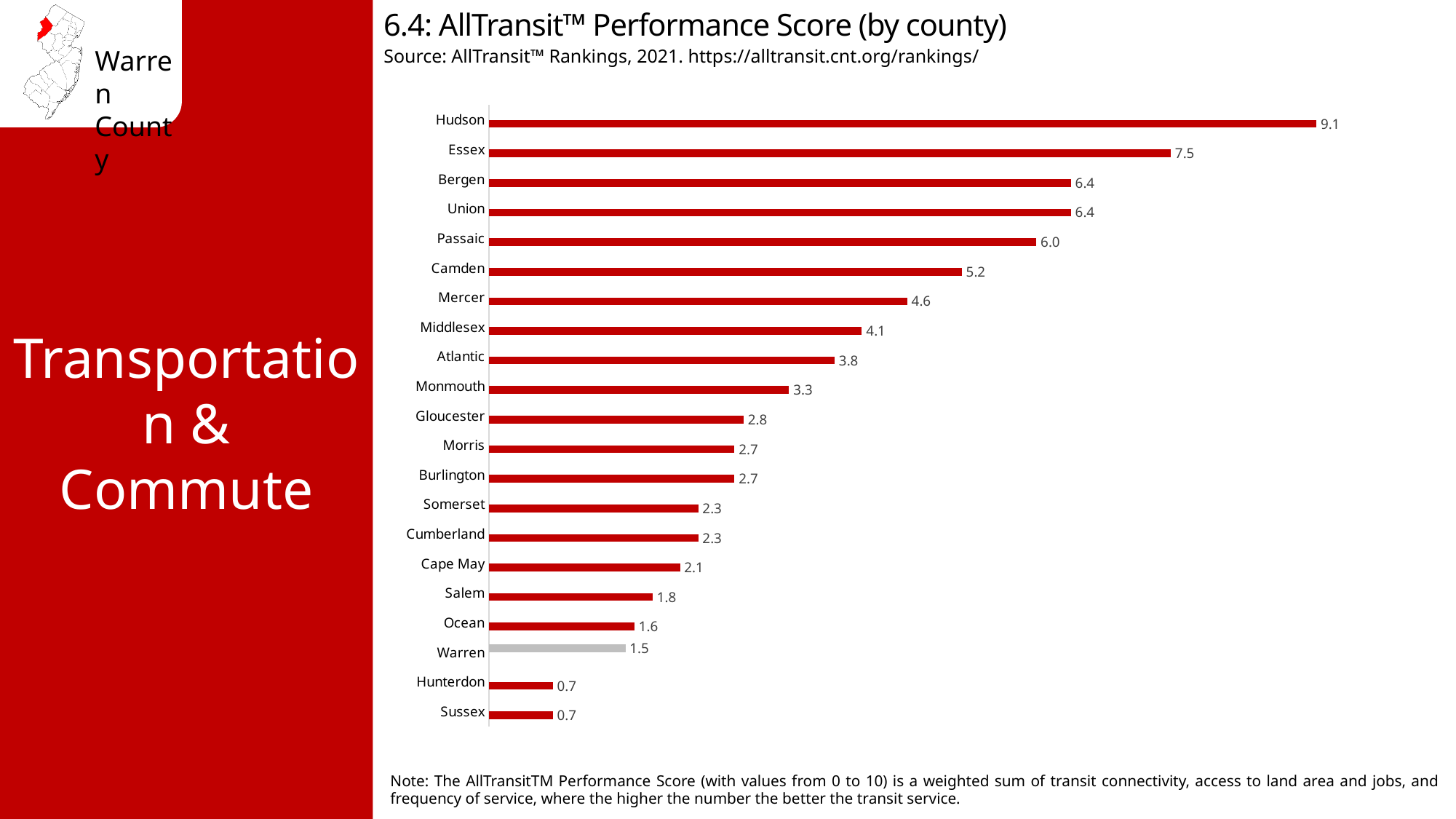
Which county has a higher AllTransit Performance Score, Ocean or Salem? Salem What is the AllTransit Performance Score for Cape May County? 2.1 Which county's bar is shown in grey rather than red? Warren Which county has the highest AllTransit Performance Score? Hudson What is the AllTransit Performance Score for Warren County? 1.5 Which county has a higher AllTransit Performance Score, Passaic or Camden? Passaic What is the difference between the AllTransit Performance Scores of Hudson and Warren counties? 7.6 What is the AllTransit Performance Score for Mercer County? 4.6 How many counties are shown in the chart? 21 What type of chart is used to show the AllTransit Performance Score by county? Bar chart What is the AllTransit Performance Score for Hudson County? 9.1 What is the difference between the AllTransit Performance Scores of Essex and Bergen counties? 1.1